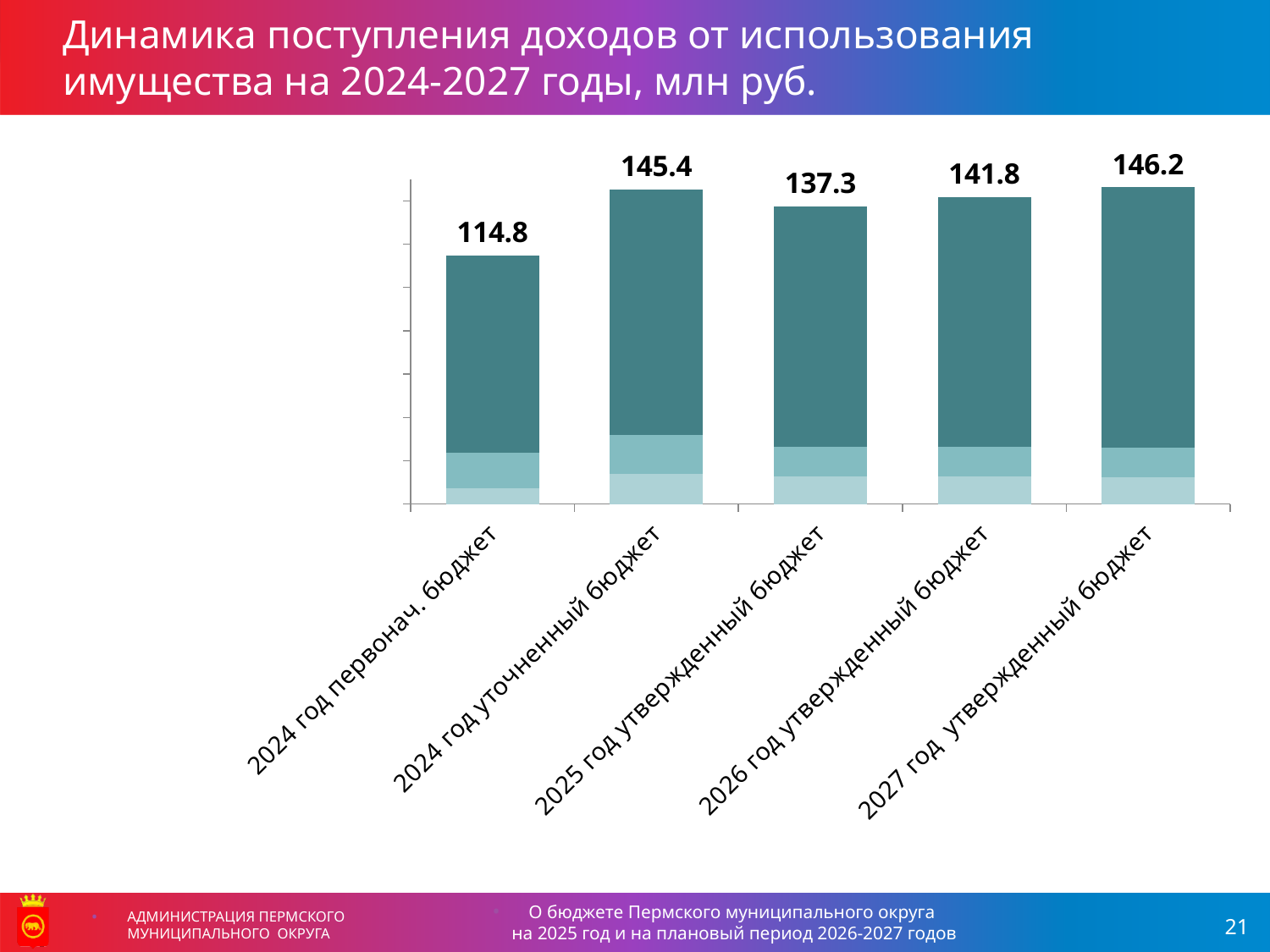
What is the difference between the totals for "2026 год утвержденный бюджет" and "2025 год утвержденный бюджет"? 4.5 What is the difference between the totals for "2024 год уточненный бюджет" and "2024 год первонач. бюджет"? 30.6 What is the total value shown for the bar labelled "2027 год утвержденный бюджет"? 146.2 Do the totals rise or fall from "2025 год утвержденный бюджет" to "2027 год утвержденный бюджет"? Rise Which category has the lowest total value? 2024 год первонач. бюджет Which category has the highest total value? 2027 год утвержденный бюджет What is the total value shown for the bar labelled "2025 год утвержденный бюджет"? 137.3 What is the total value shown for the bar labelled "2024 год уточненный бюджет"? 145.4 What is the total value shown for the bar labelled "2024 год первонач. бюджет"? 114.8 Which is larger: the total for "2024 год уточненный бюджет" or for "2025 год утвержденный бюджет"? 2024 год уточненный бюджет What kind of chart is shown on the slide? Stacked bar chart How many bars (categories) are shown in the chart? 5